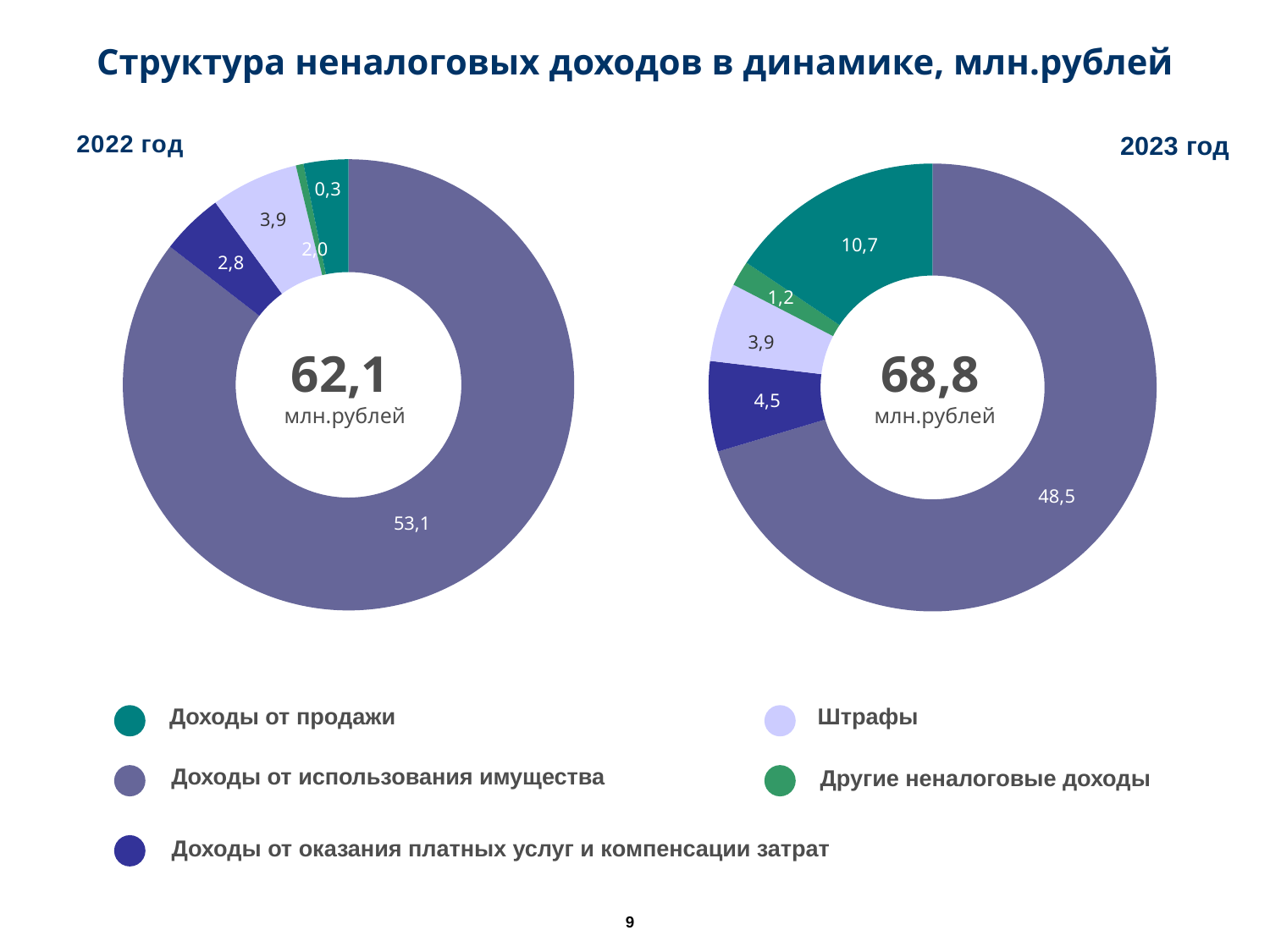
What is the title of the slide? Структура неналоговых доходов в динамике, млн.рублей On the 2023 год chart, what is the value for Доходы от продажи? 10,7 What is the difference between Доходы от продажи in 2023 год and in 2022 год? 8,7 On the 2022 год chart, what is the value for Другие неналоговые доходы? 0,3 How many categories does the legend list? 5 On the 2022 год chart, which category has the largest value? Доходы от использования имущества What is the total shown in the centre of the 2023 год chart? 68,8 млн.рублей On the 2022 год chart, what is the value for Доходы от использования имущества? 53,1 On the 2023 год chart, what is the value for Доходы от оказания платных услуг и компенсации затрат? 4,5 What type of chart is used for 2022 год and 2023 год? Donut (pie) chart Which is larger: Штрафы in 2022 год or Доходы от оказания платных услуг и компенсации затрат in 2022 год? Штрафы On the 2023 год chart, which category has the smallest value? Другие неналоговые доходы